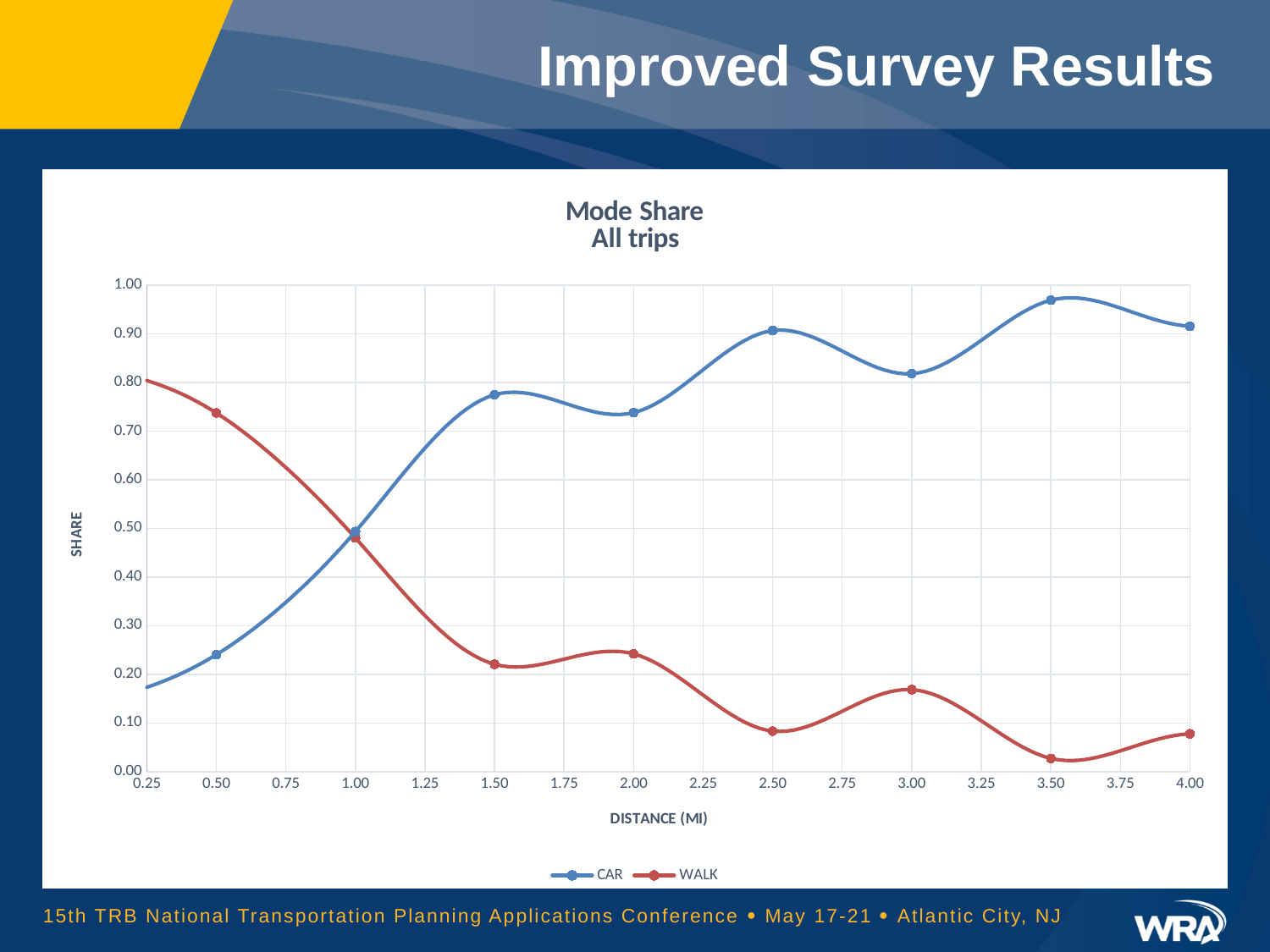
At a distance of 2.00, which series has the larger share, CAR or WALK? CAR At which distance is the WALK share highest? 0.25 What is the label of the vertical axis? SHARE Is the CAR share at a distance of 3.50 greater or less than 0.90? greater Does the WALK share generally rise or fall as distance increases? fall At which distance does the CAR series reach its highest share? 3.50 How many series does the legend list? 2 At which distance does the WALK series reach its lowest share? 3.50 At a distance of 0.50, which series has the larger share, CAR or WALK? WALK What kind of chart is shown on the slide? line chart What are the two series named in the legend? CAR and WALK